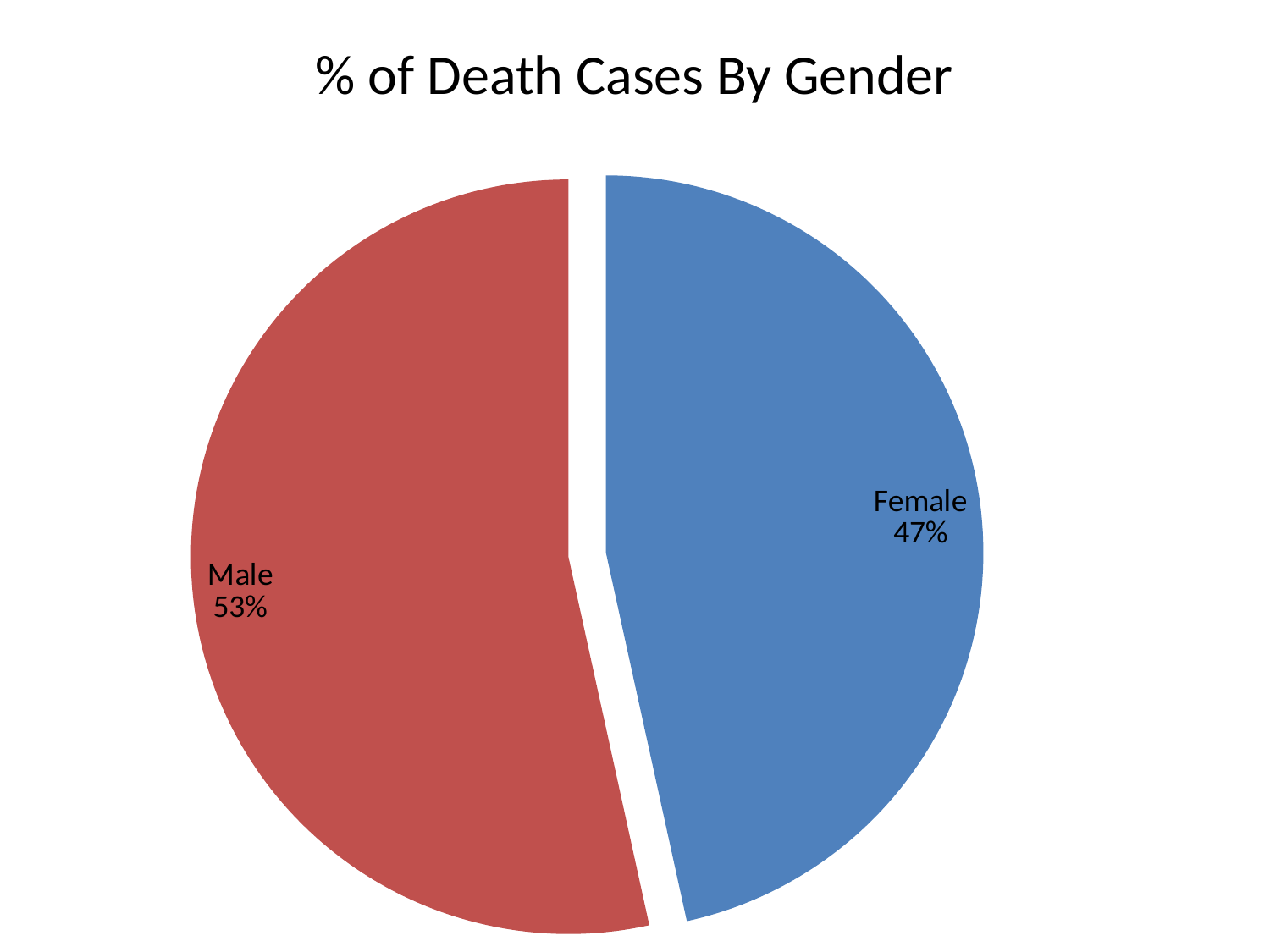
What is the title of the chart? % of Death Cases By Gender What colour is the Male slice? red How many slices does the pie chart have? 2 What percentage of death cases are Female? 47% What is the difference in percentage points between the Male and Female shares? 6 What kind of chart is shown on the slide? pie chart Which gender has the smaller share of death cases? Female Is the Male share larger or smaller than the Female share? larger What percentage of death cases are Male? 53% What share of the pie does the Female slice represent? 47% Which gender has the larger share of death cases? Male